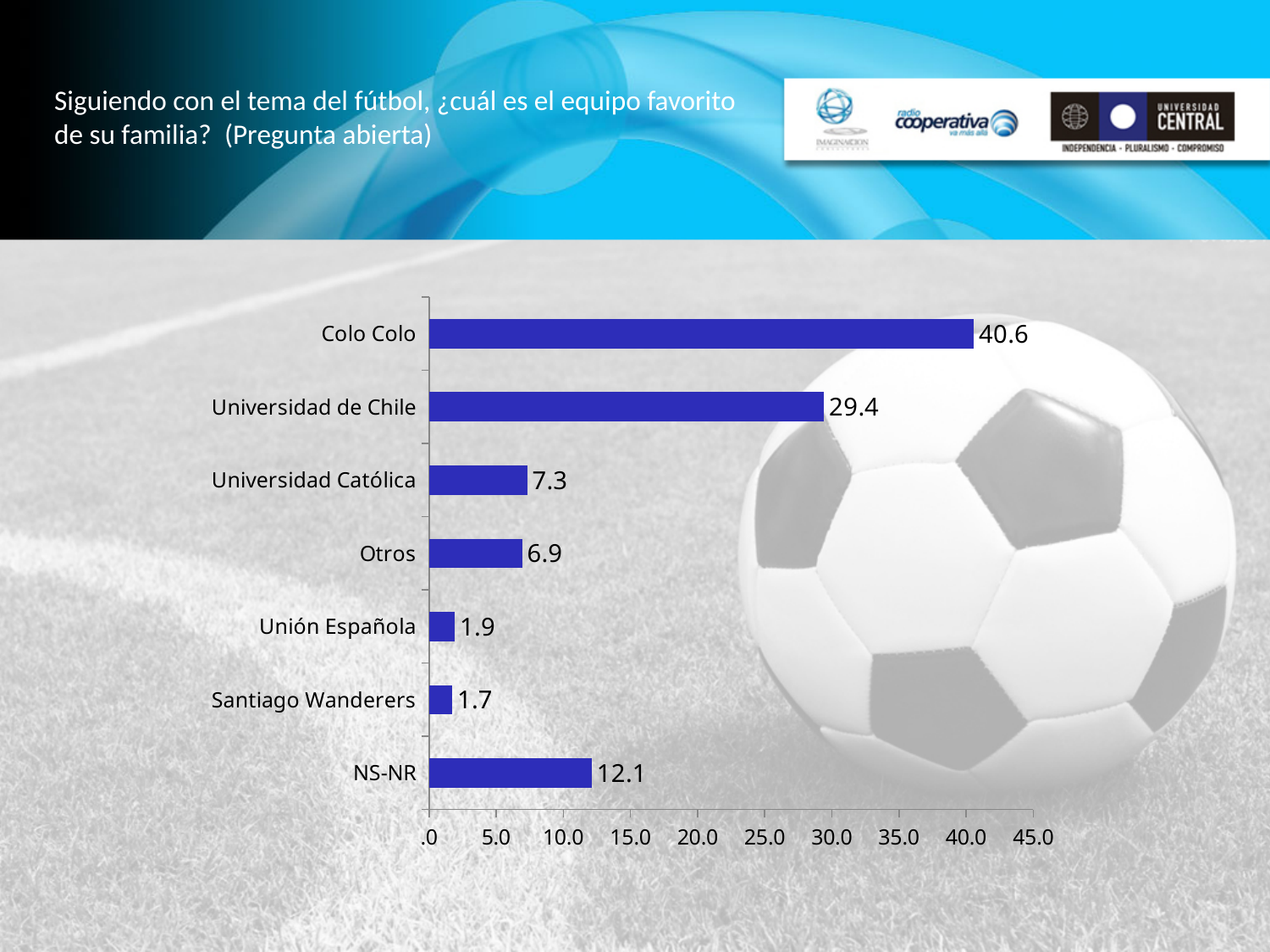
Which is larger, the value for Universidad Católica or the value for Otros? Universidad Católica Is the value for Universidad de Chile greater or less than 25.0? greater What is the difference between the values for Unión Española and Santiago Wanderers? 0.2 What is the value for Universidad de Chile? 29.4 Which category has the highest value? Colo Colo What kind of chart is shown on the slide? bar chart What is the value for Colo Colo? 40.6 What is the difference between the values for Colo Colo and Universidad de Chile? 11.2 Which category has the lowest value? Santiago Wanderers How many categories are shown in the chart? 7 What is the value for NS-NR? 12.1 What is the value for Santiago Wanderers? 1.7